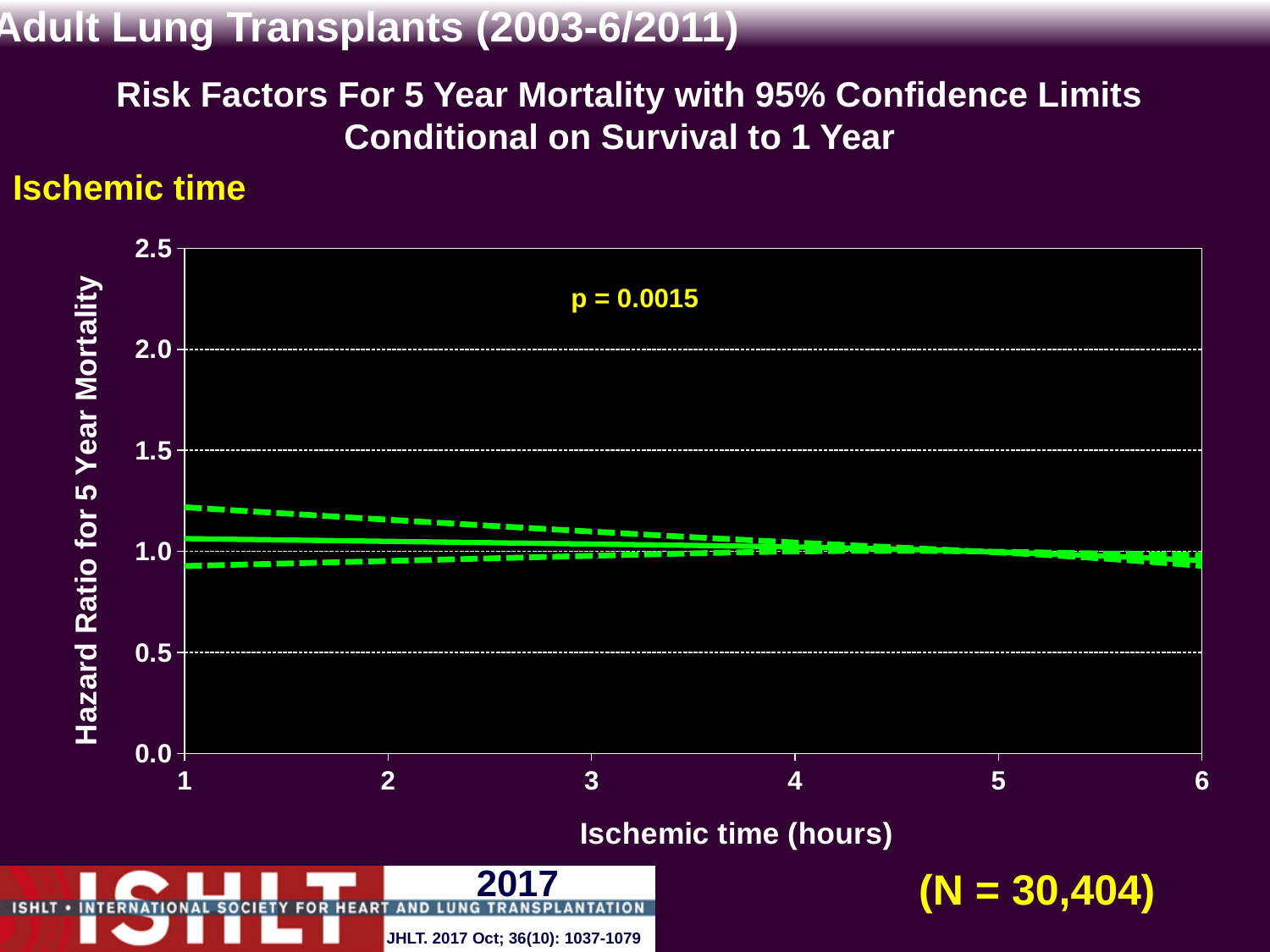
Is the upper 95% confidence limit at an ischemic time of 1 hour greater or less than 1.5? less Is the hazard ratio at an ischemic time of 6 hours greater or less than 1.5? less How many lines are plotted on the chart? 3 Is the hazard ratio (solid line) at an ischemic time of 1 hour greater or less than 1.0? greater What sample size (N) is shown on the slide? N = 30,404 What kind of chart is shown on the slide? line chart What p-value is printed on the chart? p = 0.0015 At which ischemic time shown on the x axis is the hazard ratio (solid line) higher, 1 hour or 6 hours? 1 hour Does the hazard ratio for 5 year mortality rise or fall as ischemic time increases from 1 to 6 hours? fall How many tick values are labelled on the x axis (Ischemic time in hours)? 6